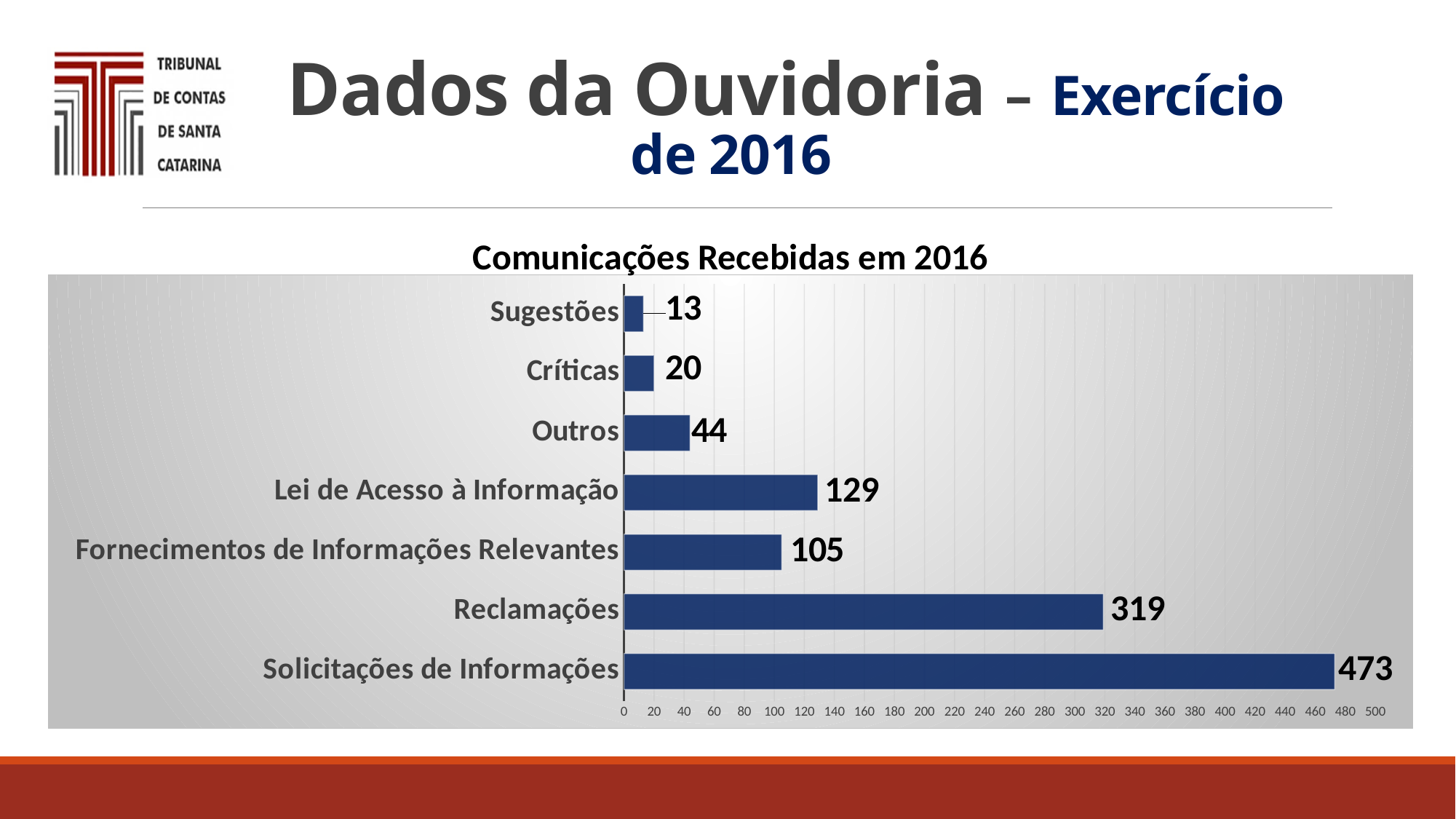
What is the title of the chart? Comunicações Recebidas em 2016 Which category has the highest value? Solicitações de Informações What is the difference between Outros and Críticas? 24 What kind of chart is shown on the slide? Bar chart Which category has the lowest value? Sugestões What is the difference between Solicitações de Informações and Reclamações? 154 How many categories are shown in the chart? 7 What is the value for Reclamações? 319 What is the value for Fornecimentos de Informações Relevantes? 105 Is the value for Reclamações greater or less than 300? greater Which is larger, Lei de Acesso à Informação or Fornecimentos de Informações Relevantes? Lei de Acesso à Informação What is the value for Lei de Acesso à Informação? 129